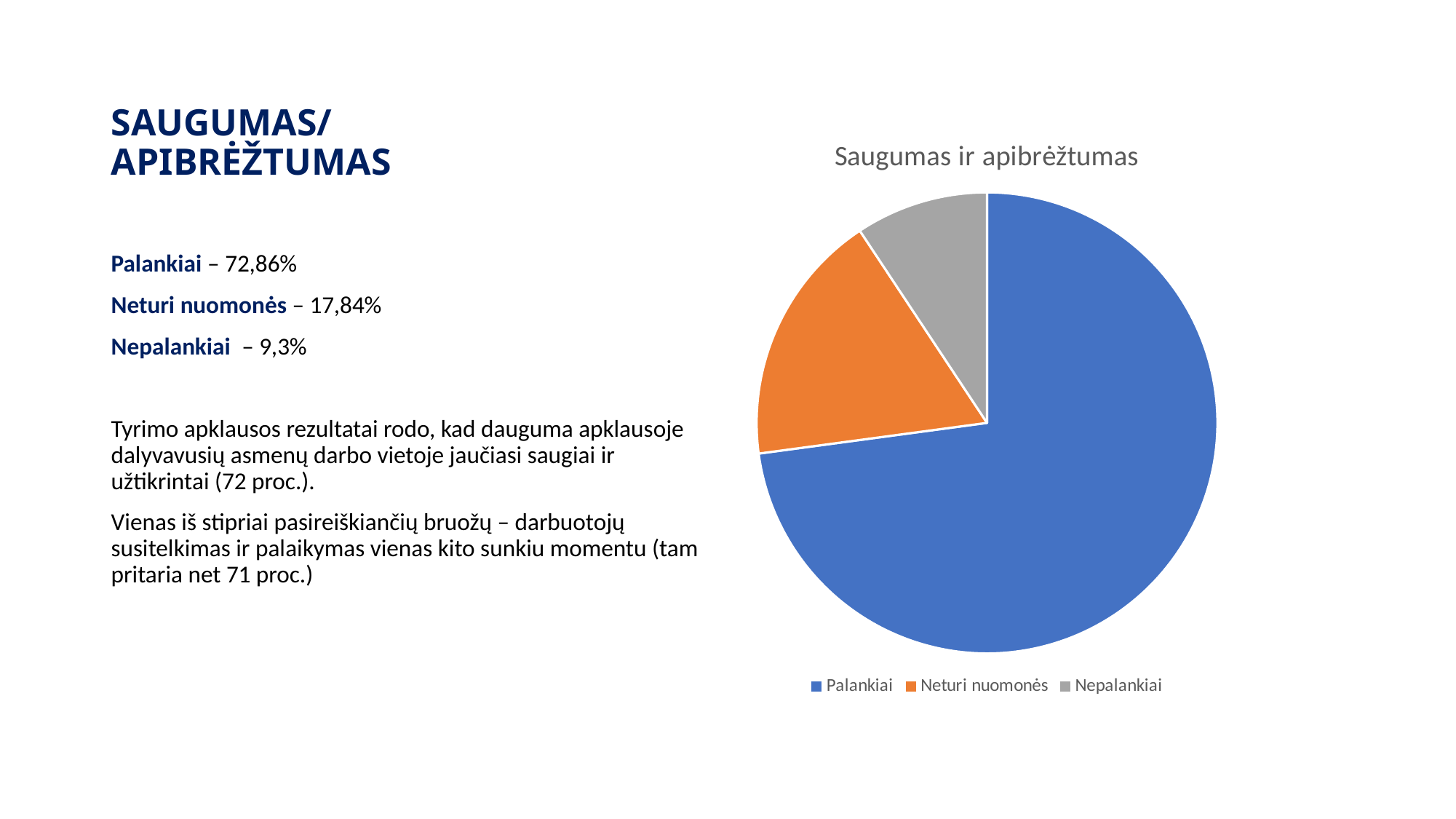
Which colour is used for the Nepalankiai slice? grey What share of the pie does Nepalankiai represent, according to the slide? 9,3% What kind of chart is shown on the slide? pie chart What share of the pie does Palankiai represent, according to the slide? 72,86% What share of the pie does Neturi nuomonės represent, according to the slide? 17,84% How many slices does the pie chart have? 3 Which category has the largest slice of the pie? Palankiai How many entries does the chart legend list? 3 Which category has the smallest slice of the pie? Nepalankiai What is the difference between the Palankiai share and the Neturi nuomonės share? 55,02% What is the title of the chart? Saugumas ir apibrėžtumas Which slice is larger: Neturi nuomonės or Nepalankiai? Neturi nuomonės